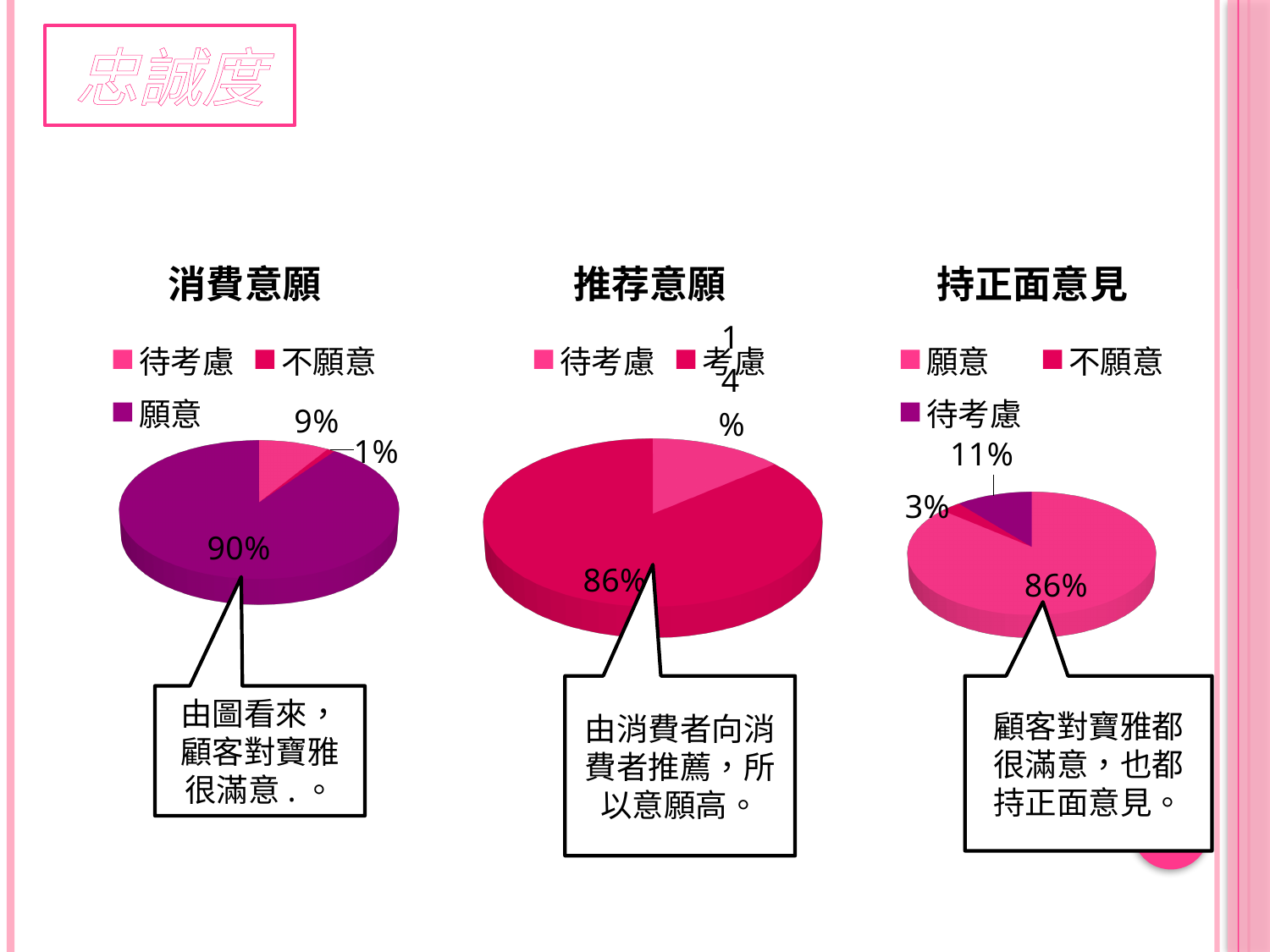
In the 持正面意見 chart, what is the difference between the 願意 share and the 待考慮 share? 75% In the 持正面意見 chart, what share is labelled for 願意? 86% In the 持正面意見 chart, which category has the smallest slice? 不願意 What kind of chart is the 消費意願 chart? pie chart In the 消費意願 chart, what share is labelled for 不願意? 1% In the 持正面意見 chart, what share is labelled for 待考慮? 11% In the 消費意願 chart, what share is labelled for 待考慮? 9% In the 消費意願 chart, which category has the smallest slice? 不願意 How many entries does the legend of the 消費意願 chart list? 3 In the 推荐意願 chart, what is the value of the largest slice? 86% In the 消費意願 chart, what share is labelled for 願意? 90% In the 消費意願 chart, which category has the largest slice? 願意